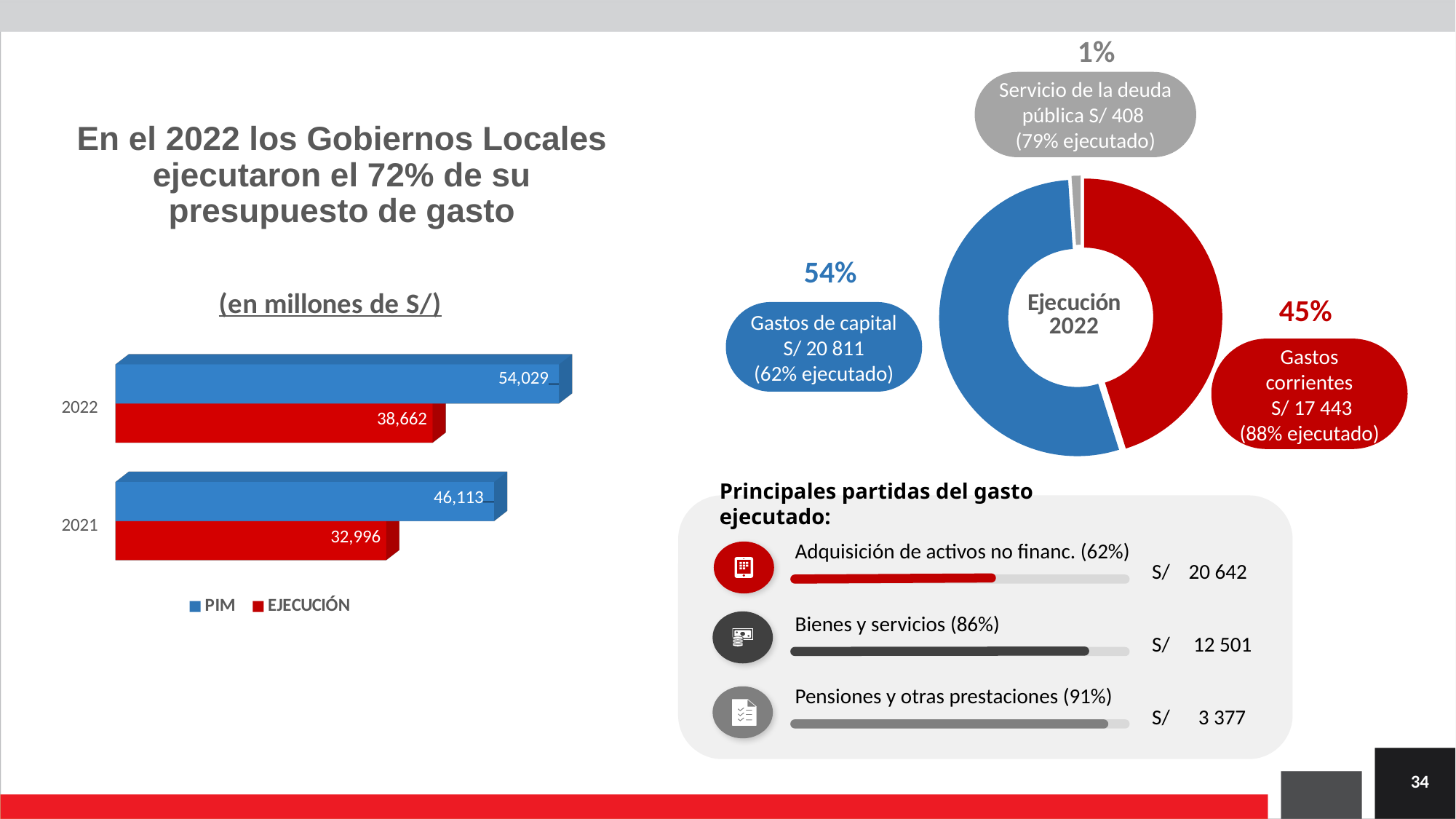
In the doughnut chart titled 'Ejecución 2022', what is the amount shown for Gastos corrientes? S/ 17 443 In the bar chart on the left, which year has the higher EJECUCIÓN value? 2022 In the bar chart on the left, what is the difference between PIM and EJECUCIÓN for 2022? 15,367 In the doughnut chart titled 'Ejecución 2022', what share does Gastos de capital represent? 54% In the bar chart on the left, what is the PIM value for 2022? 54,029 In the bar chart on the left, what is the EJECUCIÓN value for 2021? 32,996 What kind of chart is the chart on the left of the slide? Bar chart In the bar chart on the left, what is the difference between the PIM values for 2022 and 2021? 7,916 In the doughnut chart titled 'Ejecución 2022', which category has the smallest share? Servicio de la deuda pública In the bar chart on the left, which colour represents the EJECUCIÓN series? Red In the doughnut chart titled 'Ejecución 2022', how many categories are shown? 3 In the bar chart on the left, how many series does the legend list? 2